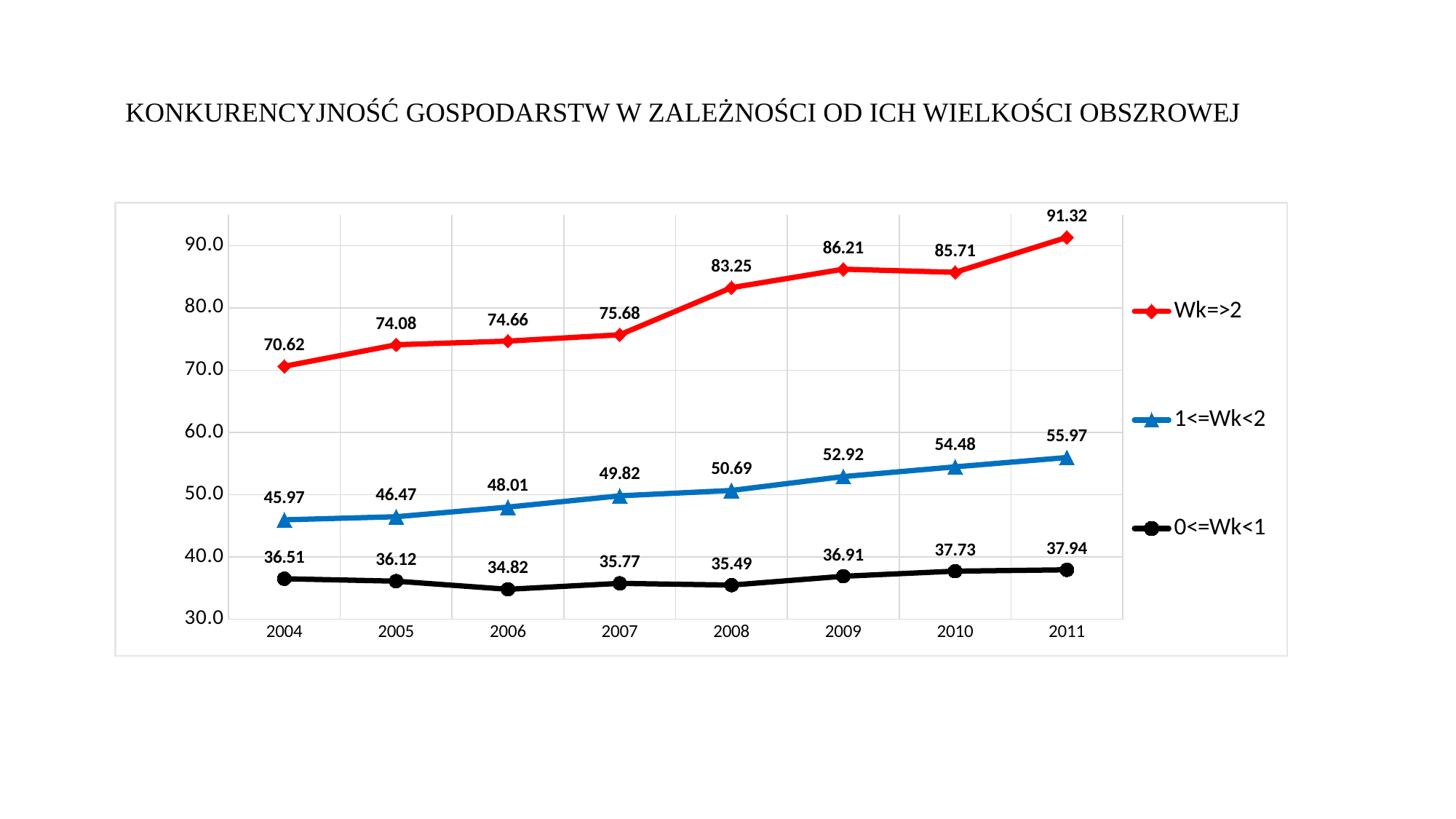
What is the value for 0<=Wk<1 in 2010? 37.73 How many years are shown on the x axis? 8 What is the value for 1<=Wk<2 in 2006? 48.01 What is the value for Wk=>2 in 2008? 83.25 Which is larger: the Wk=>2 value in 2009 or in 2010? 2009 Does the 1<=Wk<2 series rise or fall from 2004 to 2011? rise What is the difference between the Wk=>2 value in 2011 and in 2004? 20.70 In which year is the Wk=>2 series highest? 2011 In which year is the 0<=Wk<1 series lowest? 2006 How many series does the legend list? 3 What kind of chart is shown on the slide? line chart Is the value for 1<=Wk<2 in 2011 greater or less than 50.0? greater